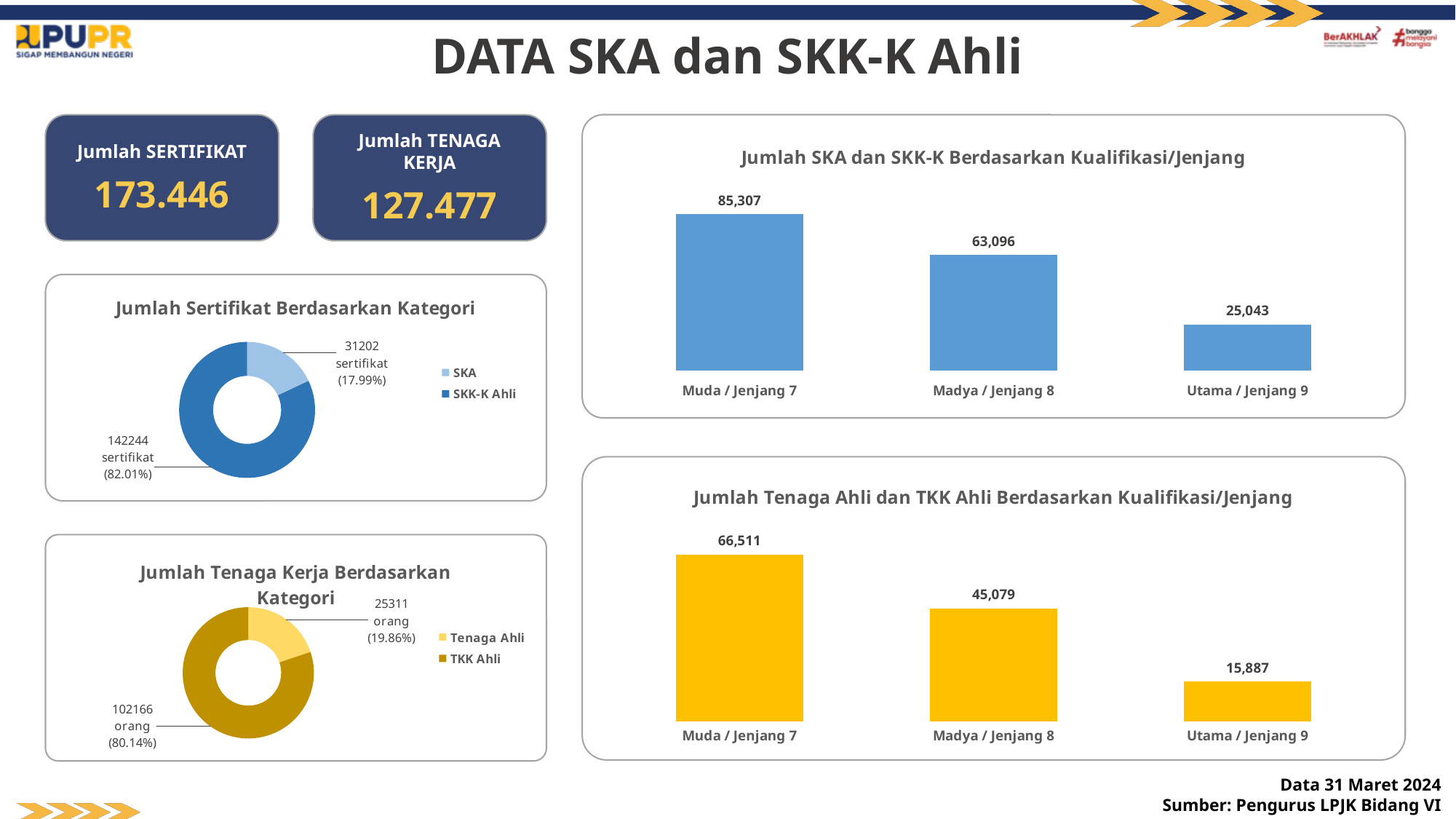
How many entries does the legend of the chart 'Jumlah Tenaga Kerja Berdasarkan Kategori' list? 2 In the chart 'Jumlah Tenaga Ahli dan TKK Ahli Berdasarkan Kualifikasi/Jenjang', what is the value for Madya / Jenjang 8? 45,079 In the chart 'Jumlah Sertifikat Berdasarkan Kategori', what share of certificates is SKK-K Ahli? 82.01% In the chart 'Jumlah SKA dan SKK-K Berdasarkan Kualifikasi/Jenjang', what is the difference between Muda / Jenjang 7 and Madya / Jenjang 8? 22,211 How many categories are shown in the chart 'Jumlah SKA dan SKK-K Berdasarkan Kualifikasi/Jenjang'? 3 In the chart 'Jumlah SKA dan SKK-K Berdasarkan Kualifikasi/Jenjang', which category has the lowest value? Utama / Jenjang 9 In the chart 'Jumlah Tenaga Kerja Berdasarkan Kategori', how many orang are Tenaga Ahli? 25311 In the chart 'Jumlah Tenaga Ahli dan TKK Ahli Berdasarkan Kualifikasi/Jenjang', do the values rise or fall from Muda / Jenjang 7 to Utama / Jenjang 9? fall What kind of chart is 'Jumlah Sertifikat Berdasarkan Kategori'? Donut chart In the chart 'Jumlah SKA dan SKK-K Berdasarkan Kualifikasi/Jenjang', what is the value for Muda / Jenjang 7? 85,307 In the chart 'Jumlah Tenaga Ahli dan TKK Ahli Berdasarkan Kualifikasi/Jenjang', what is the difference between Muda / Jenjang 7 and Utama / Jenjang 9? 50,624 In the chart 'Jumlah Tenaga Ahli dan TKK Ahli Berdasarkan Kualifikasi/Jenjang', which category has the highest value? Muda / Jenjang 7